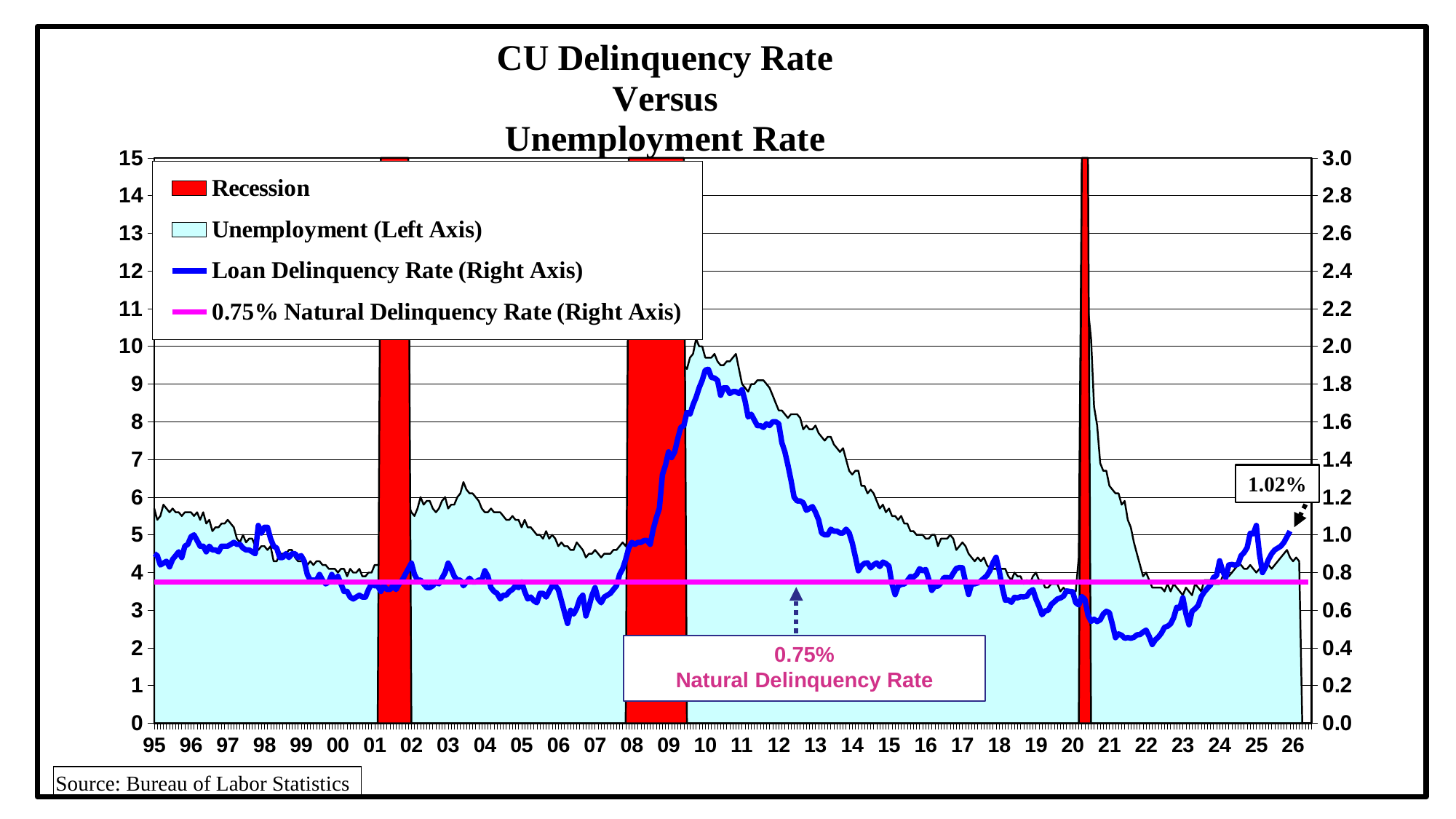
How many entries does the chart legend list? 4 What is the title of the chart? CU Delinquency Rate Versus Unemployment Rate Is the Loan Delinquency Rate around 2022 greater or less than 0.6 on the right axis? less Is the labeled latest Loan Delinquency Rate of 1.02% greater or less than the 0.75% Natural Delinquency Rate? greater What is the Natural Delinquency Rate shown by the horizontal line? 0.75% What is the most recent Loan Delinquency Rate value labeled on the chart? 1.02% What is the difference between the labeled latest Loan Delinquency Rate (1.02%) and the 0.75% Natural Delinquency Rate? 0.27% What is the source cited below the chart? Bureau of Labor Statistics Is the Unemployment value around 2000 greater or less than 5 on the left axis? less How many Recession bands are shaded on the chart? 3 Is the peak Unemployment value around 2020 greater or less than 10 on the left axis? greater Does the Unemployment series rise or fall from 2010 to 2019? fall